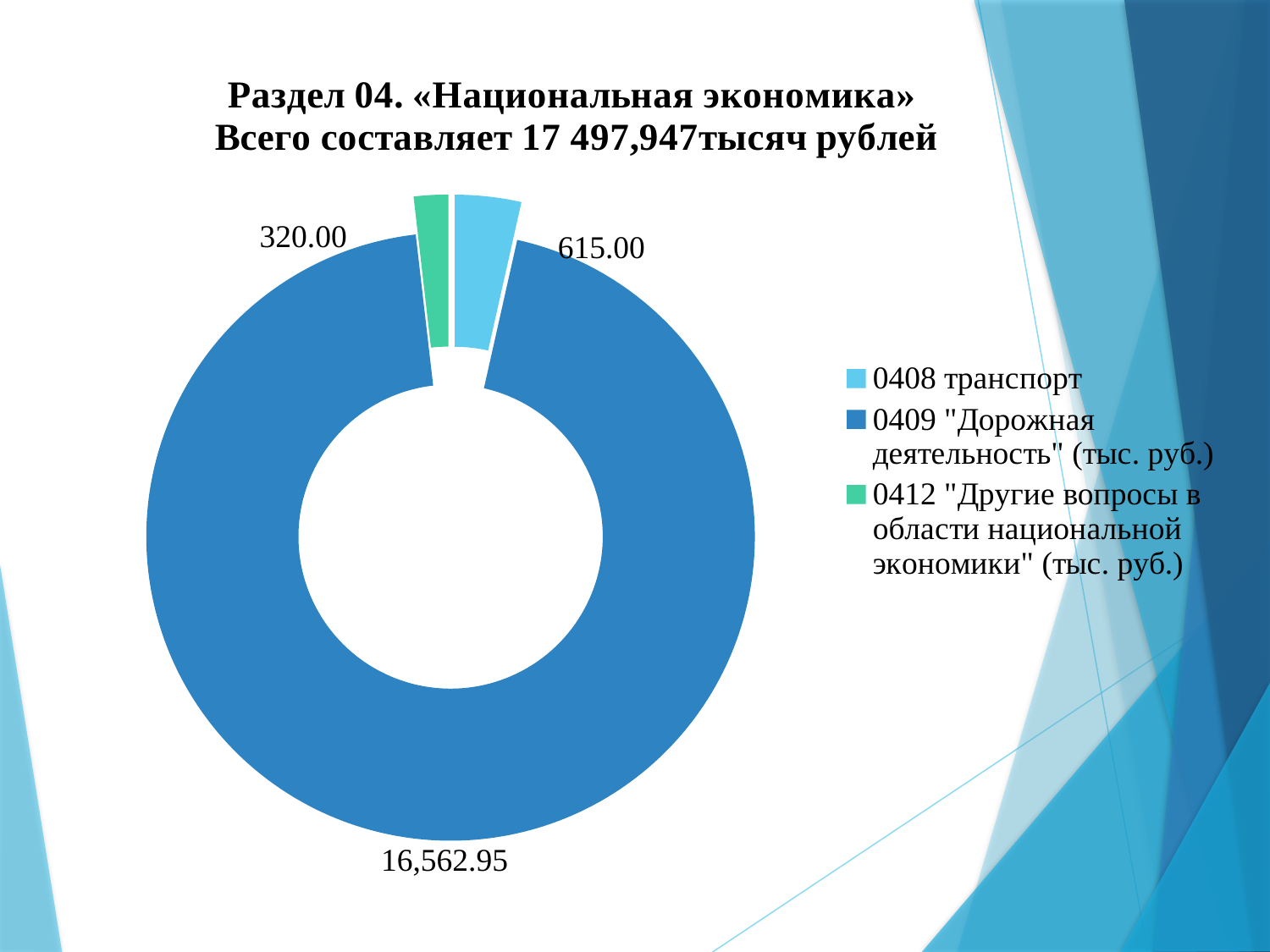
What total amount does the slide title state for Раздел 04? 17 497,947 тысяч рублей What is the value for 0409 "Дорожная деятельность"? 16,562.95 What is the difference between the values for 0409 "Дорожная деятельность" and 0408 транспорт? 15,947.95 What kind of chart is shown on the slide? Doughnut (pie) chart Which is larger, the value for 0408 транспорт or the value for 0412 "Другие вопросы в области национальной экономики"? 0408 транспорт What is the value for 0412 "Другие вопросы в области национальной экономики"? 320.00 What is the value for 0408 транспорт? 615.00 What is the difference between the values for 0408 транспорт and 0412 "Другие вопросы в области национальной экономики"? 295.00 How many categories does the chart show? 3 Which category has the largest slice? 0409 "Дорожная деятельность" What colour is the slice for 0412 "Другие вопросы в области национальной экономики"? Green Which category has the smallest slice? 0412 "Другие вопросы в области национальной экономики"